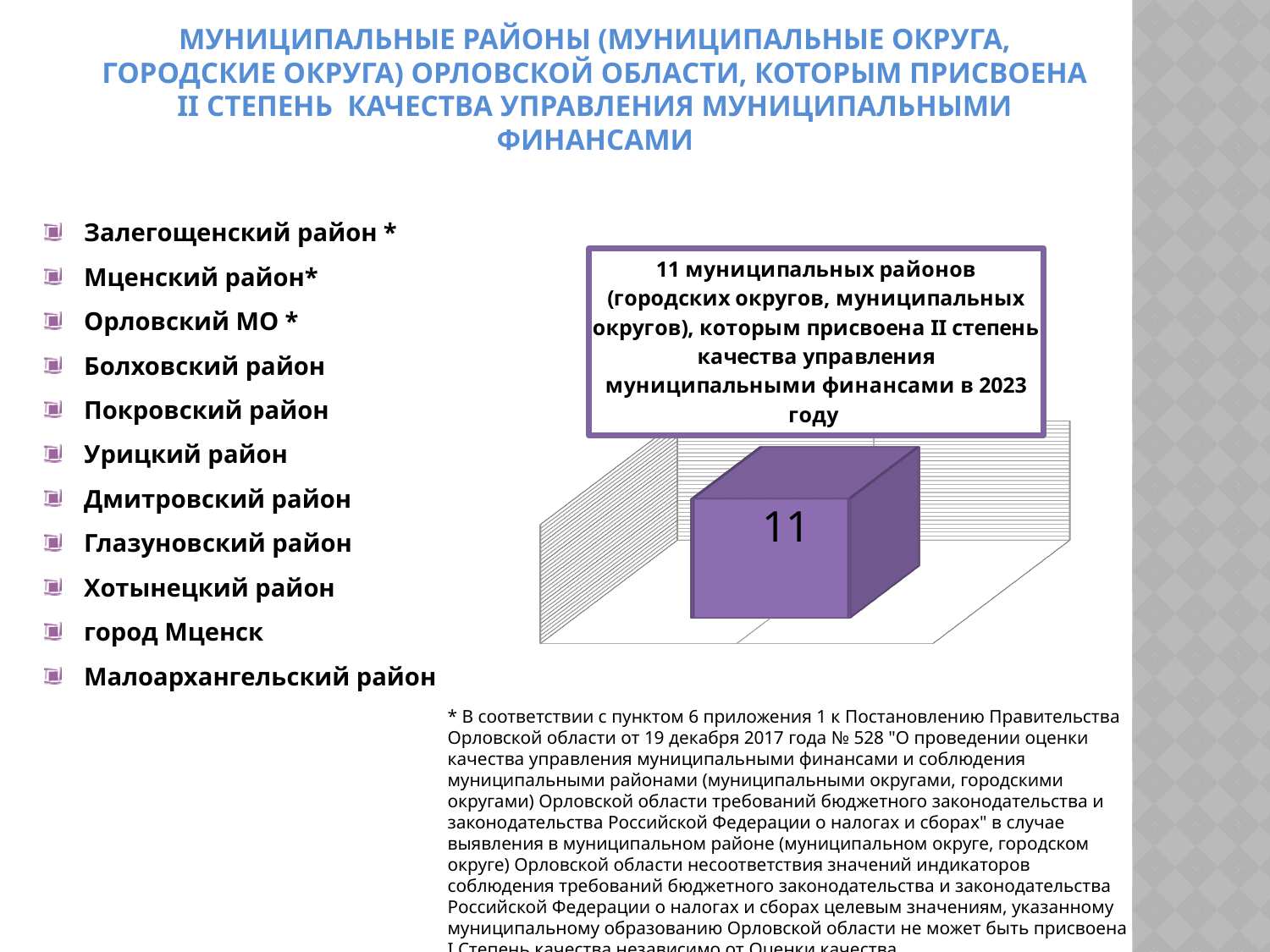
What kind of chart is shown on the slide? bar chart According to the chart's title, in which year were 11 municipal districts assigned the II degree of quality of municipal finance management? 2023 What colour is the bar in the chart? purple What value is printed on the bar in the chart? 11 How many bars does the chart show? 1